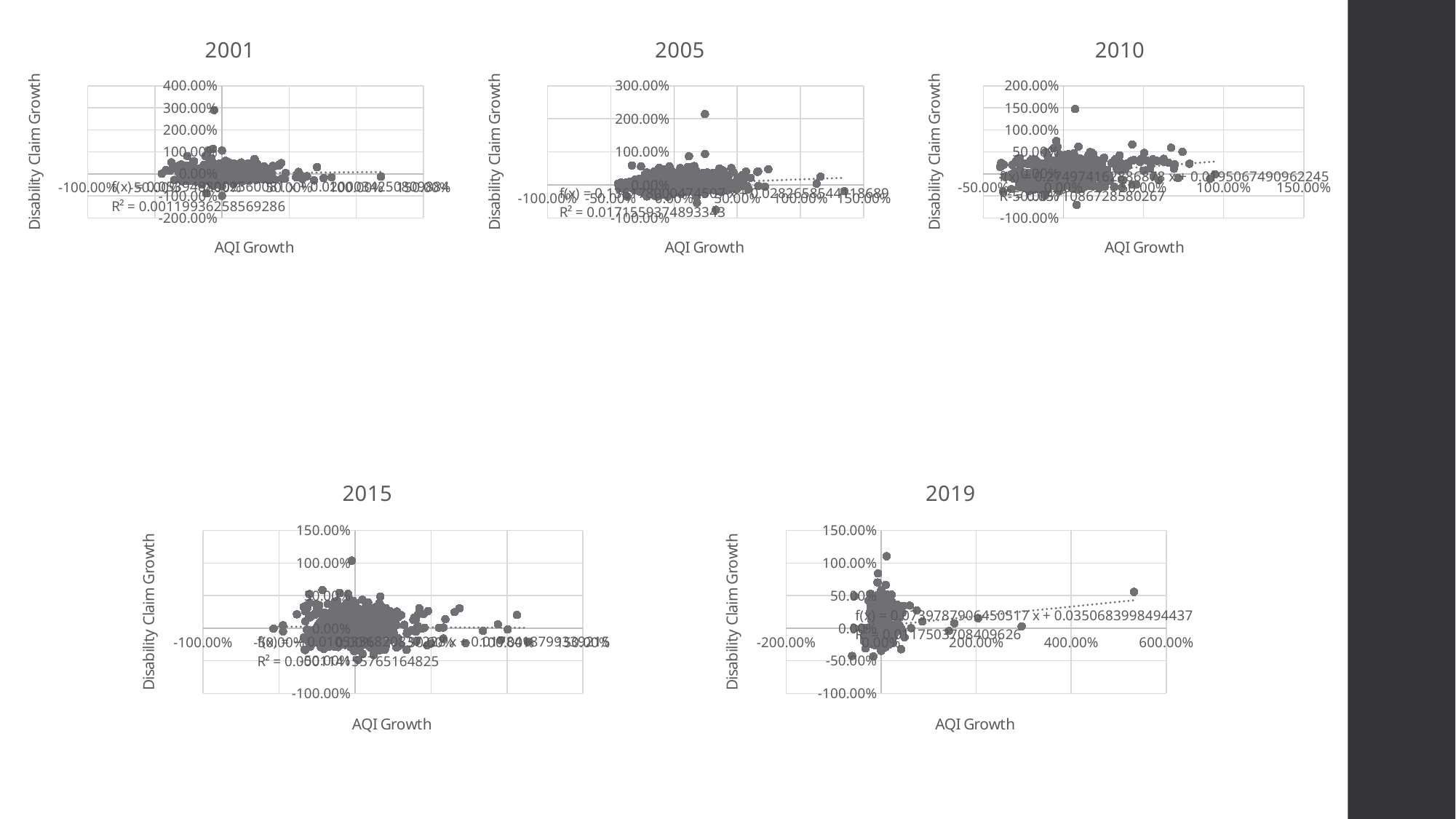
What is the R² value printed on the chart titled 2005? 0.0171559374893343 In the chart titled 2010, is the Disability Claim Growth of the highest point greater or less than 100.00%? greater What kind of chart is the one titled 2001? Scatter chart In the chart titled 2005, what is the highest value shown on the y-axis? 300.00% In the chart titled 2005, is the Disability Claim Growth of the highest point greater or less than 200.00%? greater In the chart titled 2001, what is the highest value shown on the y-axis? 400.00% What is the y-axis title of the chart titled 2019? Disability Claim Growth What is the x-axis title of the chart titled 2005? AQI Growth In the chart titled 2001, is the Disability Claim Growth of the highest point greater or less than 200.00%? greater In the chart titled 2019, what is the highest value shown on the x-axis? 600.00% How many charts are shown on the slide? 5